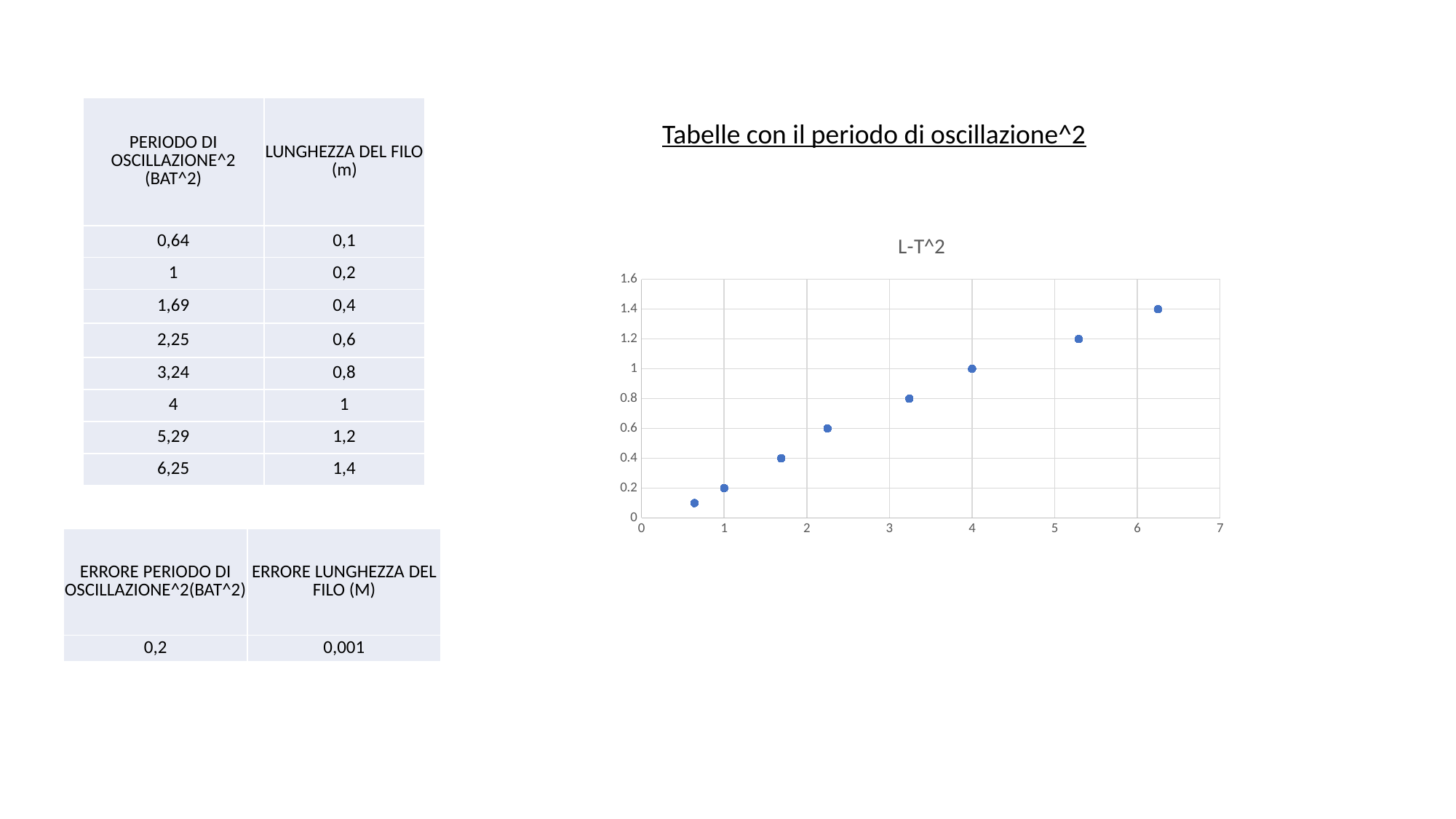
In the L-T^2 chart, which point has the higher y value: the point at x = 4 or the point at x = 1? the point at x = 4 In the L-T^2 chart, is the y value of the point between x = 3 and x = 4 greater or less than 0.6? greater In the L-T^2 chart, what is the y value of the point at x = 1? 0.2 In the L-T^2 chart, what is the y value of the rightmost point? 1.4 What kind of chart is the L-T^2 chart? scatter chart In the L-T^2 chart, do the values rise or fall as you move along the x axis? rise In the L-T^2 chart, what is the y value of the point at x = 4? 1 What is the title of the scatter chart on the slide? L-T^2 In the L-T^2 chart, what is the y value of the point lying between x = 5 and x = 6? 1.2 What is the highest tick value shown on the x axis of the L-T^2 chart? 7 In the L-T^2 chart, is the y value of the leftmost point greater or less than 0.2? less How many data points are plotted in the L-T^2 chart? 8